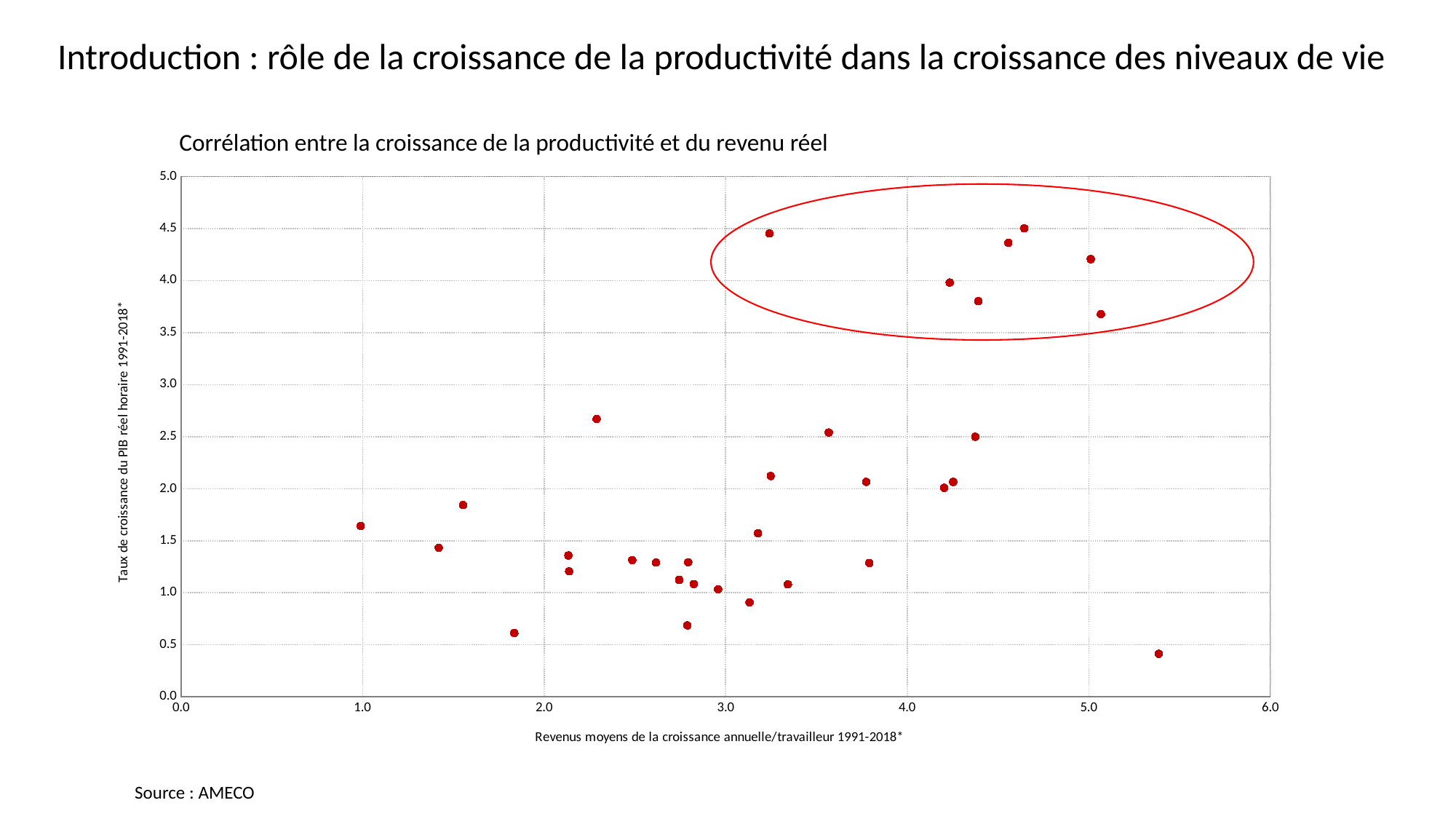
What is the label of the vertical axis of the chart? Taux de croissance du PIB réel horaire 1991-2018* Are all the points inside the red ellipse above 3.5 on the vertical axis? yes What kind of chart is shown on the slide? scatter plot Is the highest point on the chart greater or less than 4.0 on the vertical axis? greater What is the maximum value shown on the horizontal axis? 6.0 Is the lowest point on the chart greater or less than 0.5 on the vertical axis? less What is the title of the chart? Corrélation entre la croissance de la productivité et du revenu réel How many data points are enclosed by the red ellipse? 7